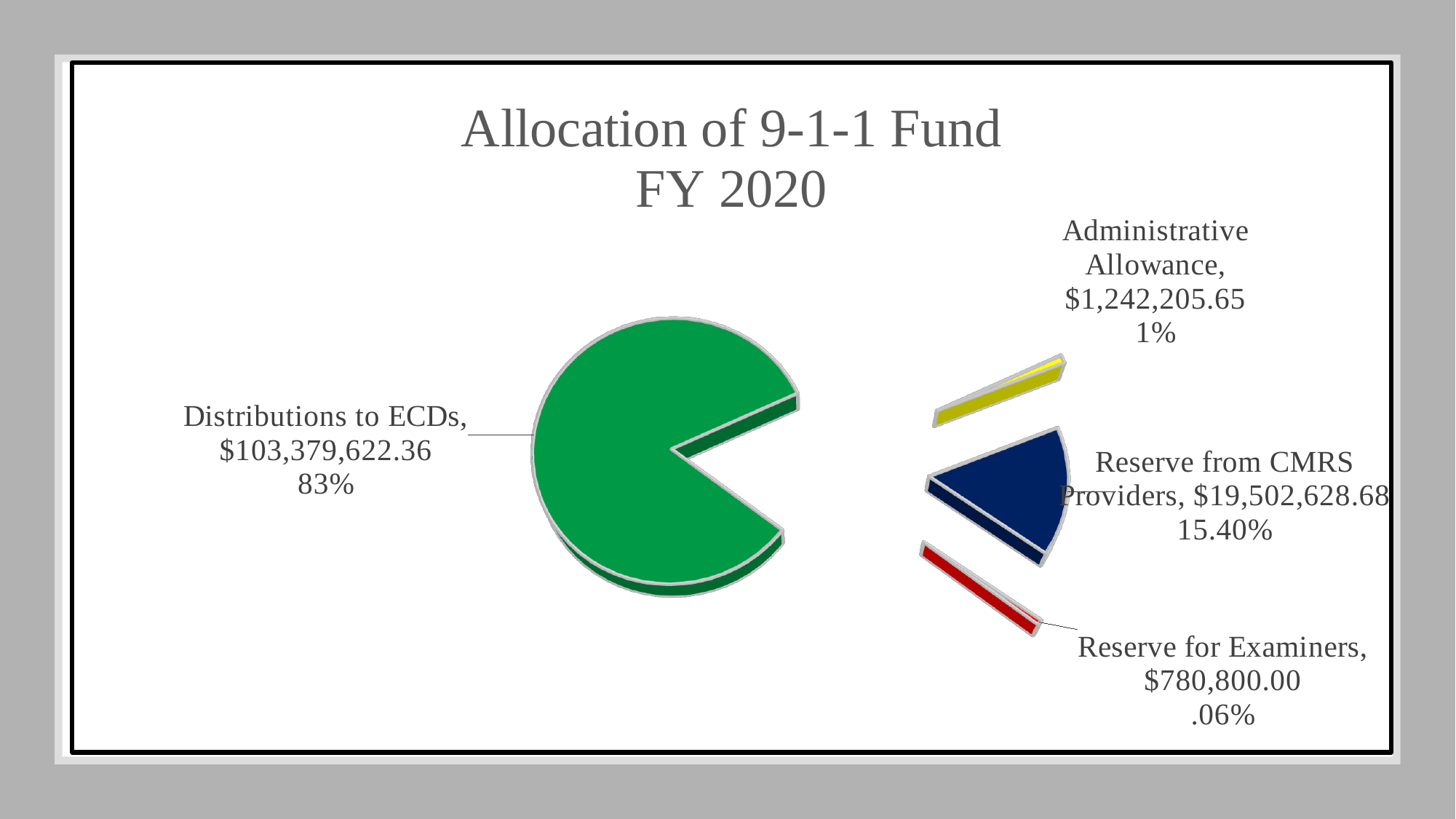
What is the title of the chart? Allocation of 9-1-1 Fund FY 2020 What is the difference between Distributions to ECDs and Reserve from CMRS Providers? $83,876,993.68 What is the dollar value for Reserve from CMRS Providers? $19,502,628.68 What share of the pie is Distributions to ECDs? 83% What is the dollar value for Administrative Allowance? $1,242,205.65 What is the dollar value for Distributions to ECDs? $103,379,622.36 How many slices does the pie chart have? 4 What kind of chart is shown on the slide? Pie chart Which category has the largest slice of the pie? Distributions to ECDs What is the dollar value for Reserve for Examiners? $780,800.00 Which category has the smallest slice of the pie? Reserve for Examiners What share of the pie is Reserve from CMRS Providers? 15.40%